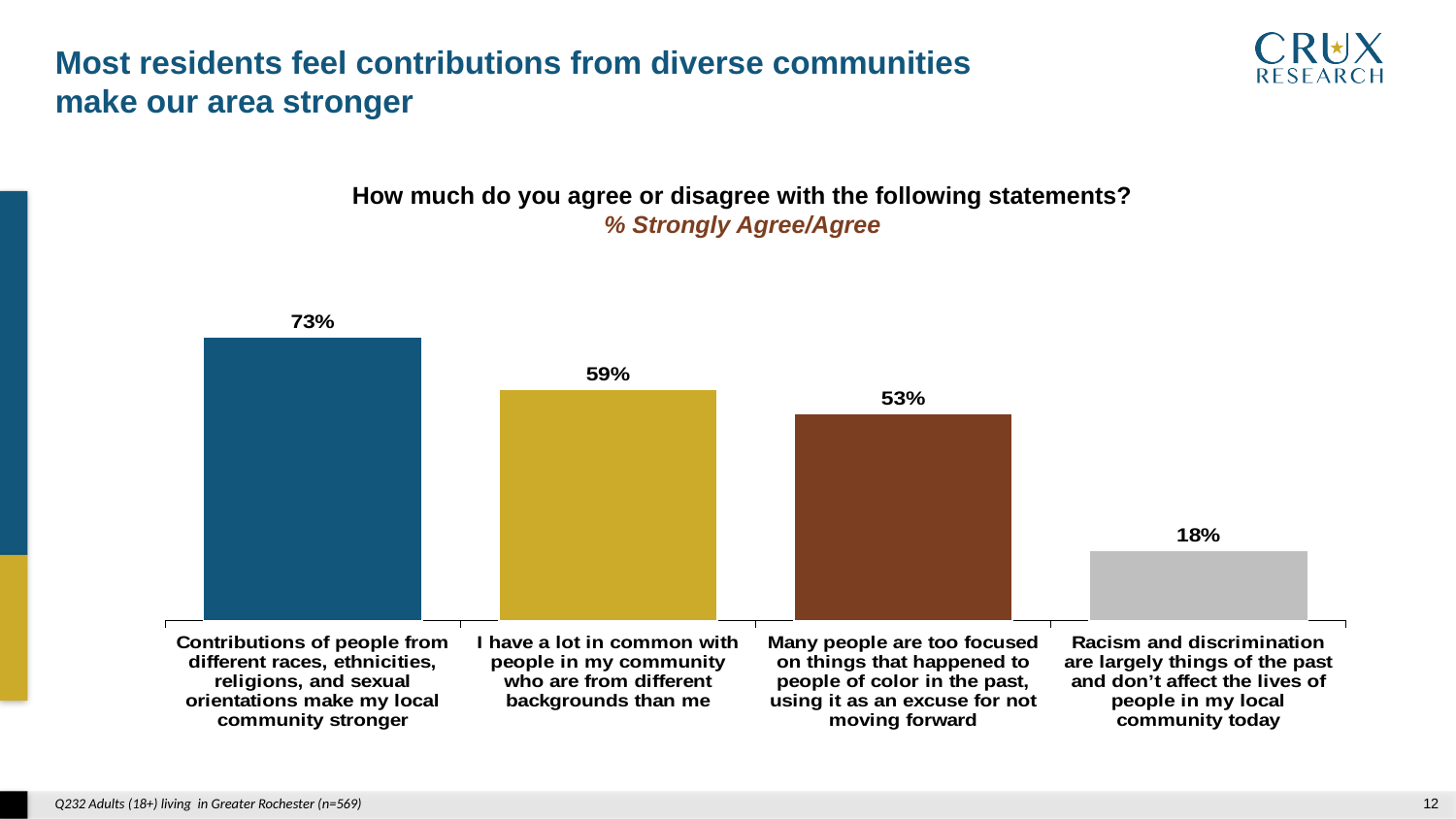
What percentage strongly agree or agree with the statement 'I have a lot in common with people in my community who are from different backgrounds than me'? 59% What is the difference in percentage points between 'I have a lot in common with people in my community who are from different backgrounds than me' and 'Many people are too focused on things that happened to people of color in the past'? 6 What type of chart is shown on the slide? Bar chart What is the difference in percentage points between the highest bar (73%) and the lowest bar (18%)? 55 Which statement has the lowest percentage of strongly agree/agree? Racism and discrimination are largely things of the past and don't affect the lives of people in my local community today Which statement has the highest percentage of strongly agree/agree? Contributions of people from different races, ethnicities, religions, and sexual orientations make my local community stronger What percentage strongly agree or agree that many people are too focused on things that happened to people of color in the past? 53% How many statements are shown in the chart? 4 Which has a higher agreement percentage: the statement about having a lot in common with people from different backgrounds, or the statement about racism and discrimination being things of the past? I have a lot in common with people in my community who are from different backgrounds than me What measure does the chart subtitle say the bars represent? % Strongly Agree/Agree What percentage of residents strongly agree or agree that contributions of people from different races, ethnicities, religions, and sexual orientations make their local community stronger? 73% What percentage strongly agree or agree that racism and discrimination are largely things of the past? 18%